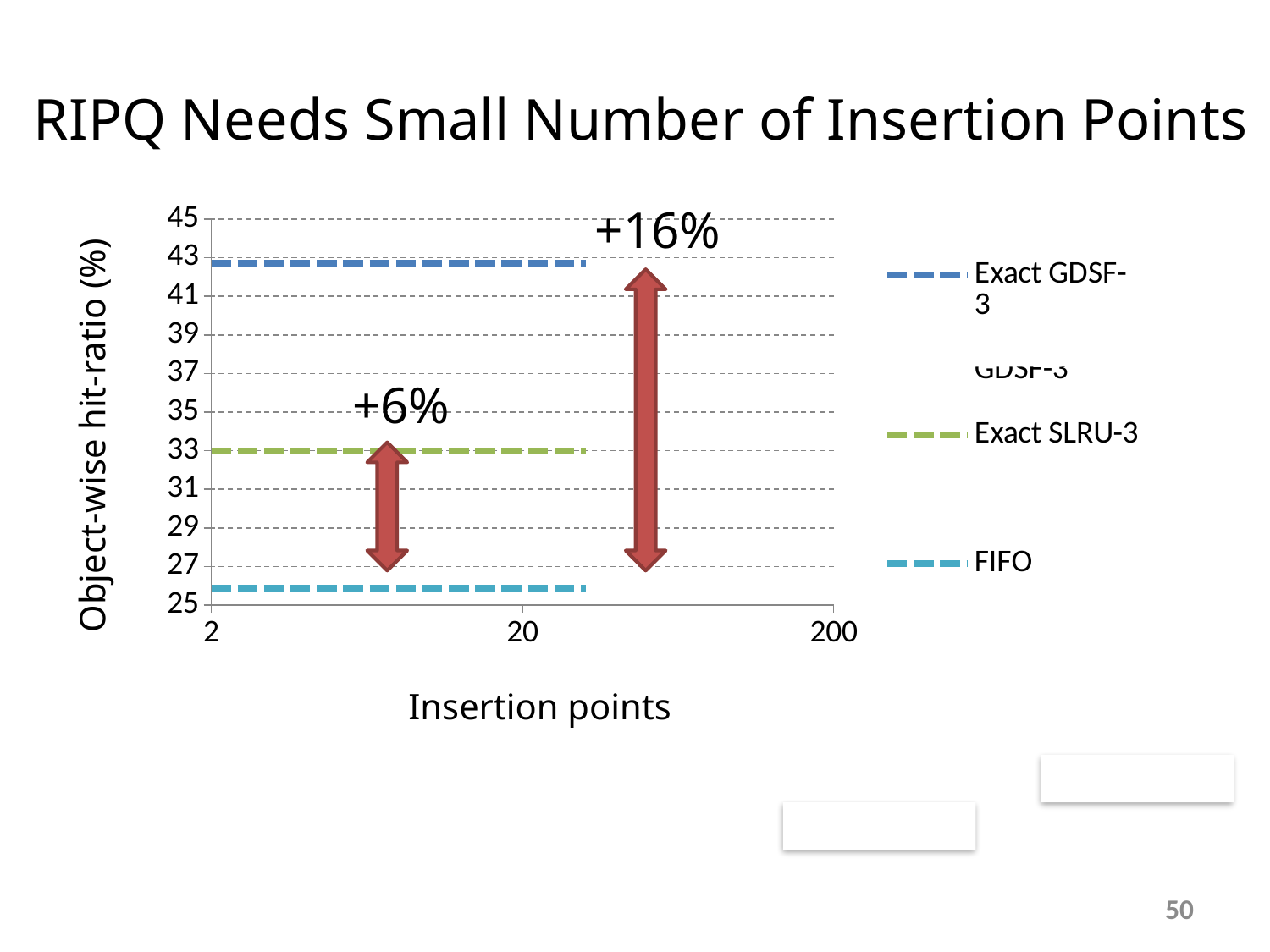
What is the label of the x axis? Insertion points What kind of chart is shown on the slide? line chart Does the Exact SLRU-3 line rise, fall, or stay flat as insertion points increase? stay flat How many labeled tick values are shown on the x axis? 3 Which series has the lowest object-wise hit-ratio? FIFO Is the object-wise hit-ratio for Exact GDSF-3 greater or less than 41? greater Which series has the highest object-wise hit-ratio? Exact GDSF-3 What percentage gain is annotated between the FIFO line and the Exact GDSF-3 line? +16% Which has a higher object-wise hit-ratio, Exact SLRU-3 or FIFO? Exact SLRU-3 What object-wise hit-ratio does the Exact SLRU-3 line sit at? 33 Is the object-wise hit-ratio for FIFO greater or less than 27? less